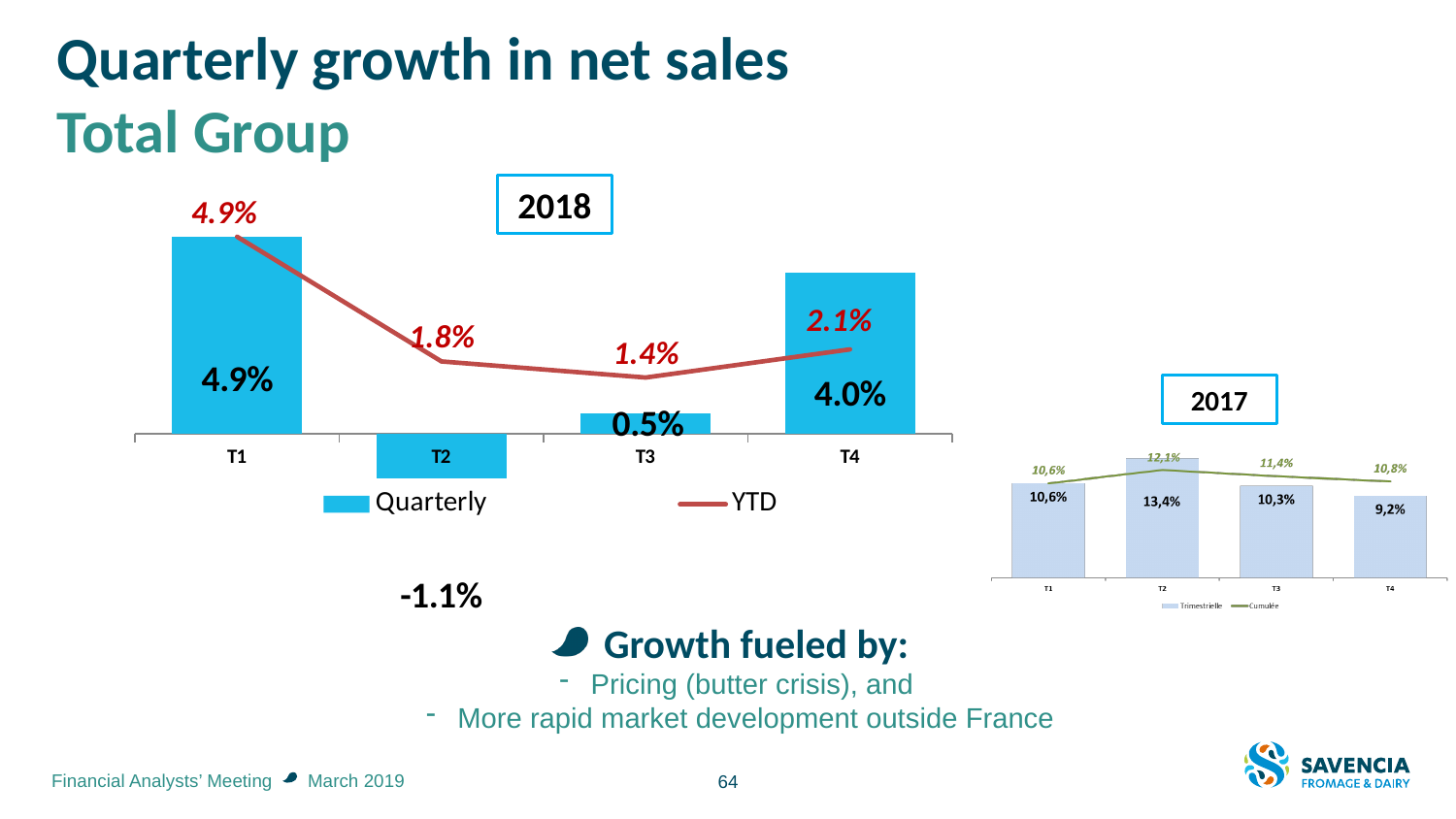
In the 2018 chart, which quarter has the lowest Quarterly value? T2 In the 2017 chart, what is the Cumulée value at T4? 10,8% In the 2018 chart, is the YTD value at T2 larger or smaller than the YTD value at T4? smaller In the 2017 chart, which quarter has the highest Trimestrielle value? T2 In the 2018 chart, what is the Quarterly value for T2? -1.1% In the 2018 chart, what is the Quarterly value for T1? 4.9% In the 2017 chart, how many quarters are shown on the x axis? 4 In the 2018 chart, what kind of chart is used for the Quarterly series? bar chart In the 2018 chart, how many series does the legend list? 2 In the 2018 chart, what is the YTD value at T3? 1.4% In the 2017 chart, what is the Trimestrielle value for T2? 13,4% In the 2018 chart, what is the difference between the Quarterly values for T1 and T4? 0.9%